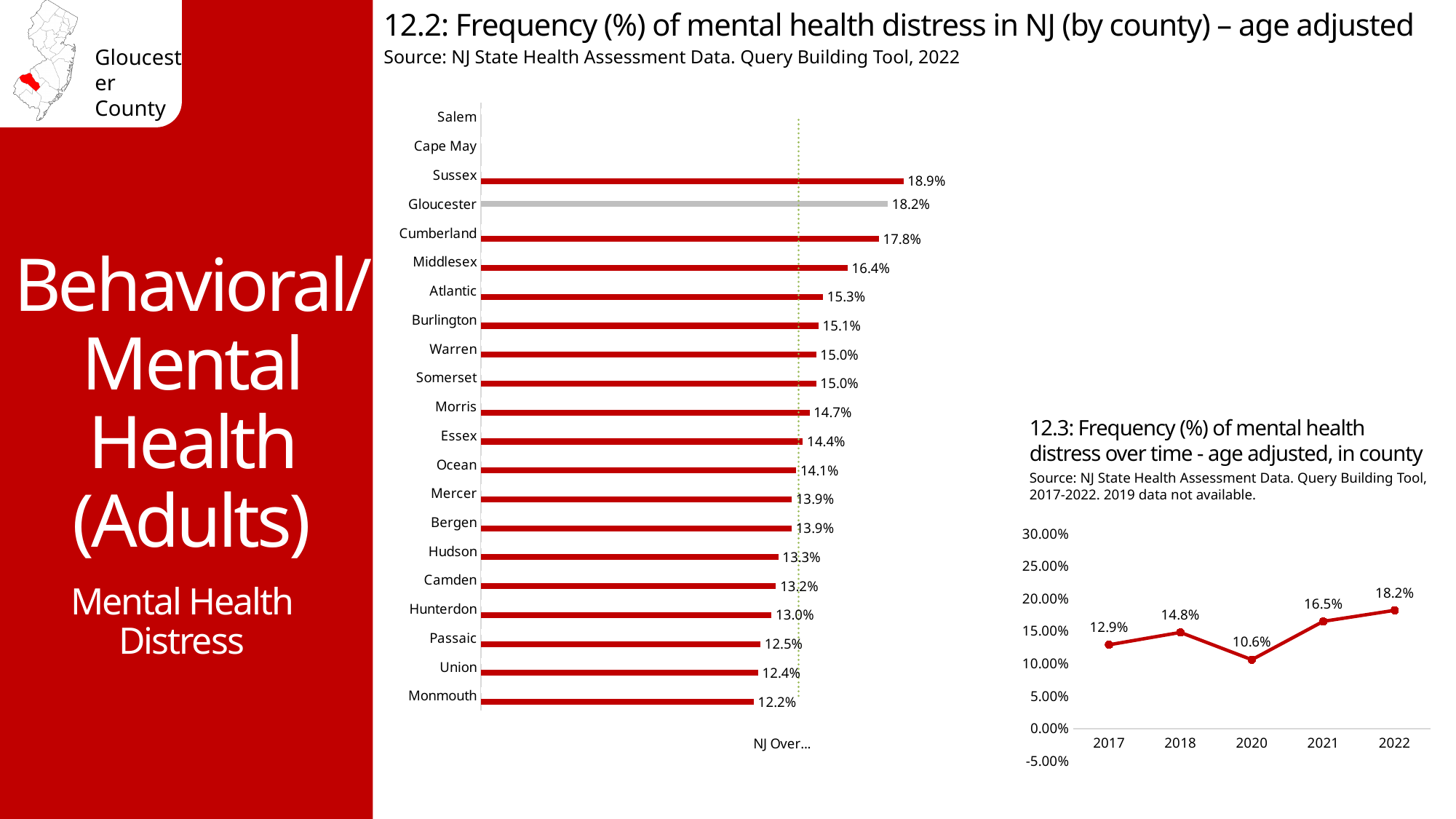
In chart 12.3, what is the value for 2020? 10.6% In chart 12.3, what is the difference between the values for 2022 and 2017? 5.3% In chart 12.3, how many years are plotted? 5 In chart 12.2, which county with a plotted bar has the lowest value? Monmouth In chart 12.2, what is the difference between the values for Sussex and Gloucester? 0.7% What kind of chart is chart 12.2? bar chart What kind of chart is chart 12.3? line chart In chart 12.2, what is the value for Gloucester? 18.2% In chart 12.2, what is the value for Cumberland? 17.8% In chart 12.2, which county has the highest value? Sussex In chart 12.2, which is larger, the value for Middlesex or the value for Atlantic? Middlesex In chart 12.3, which year has the highest value? 2022